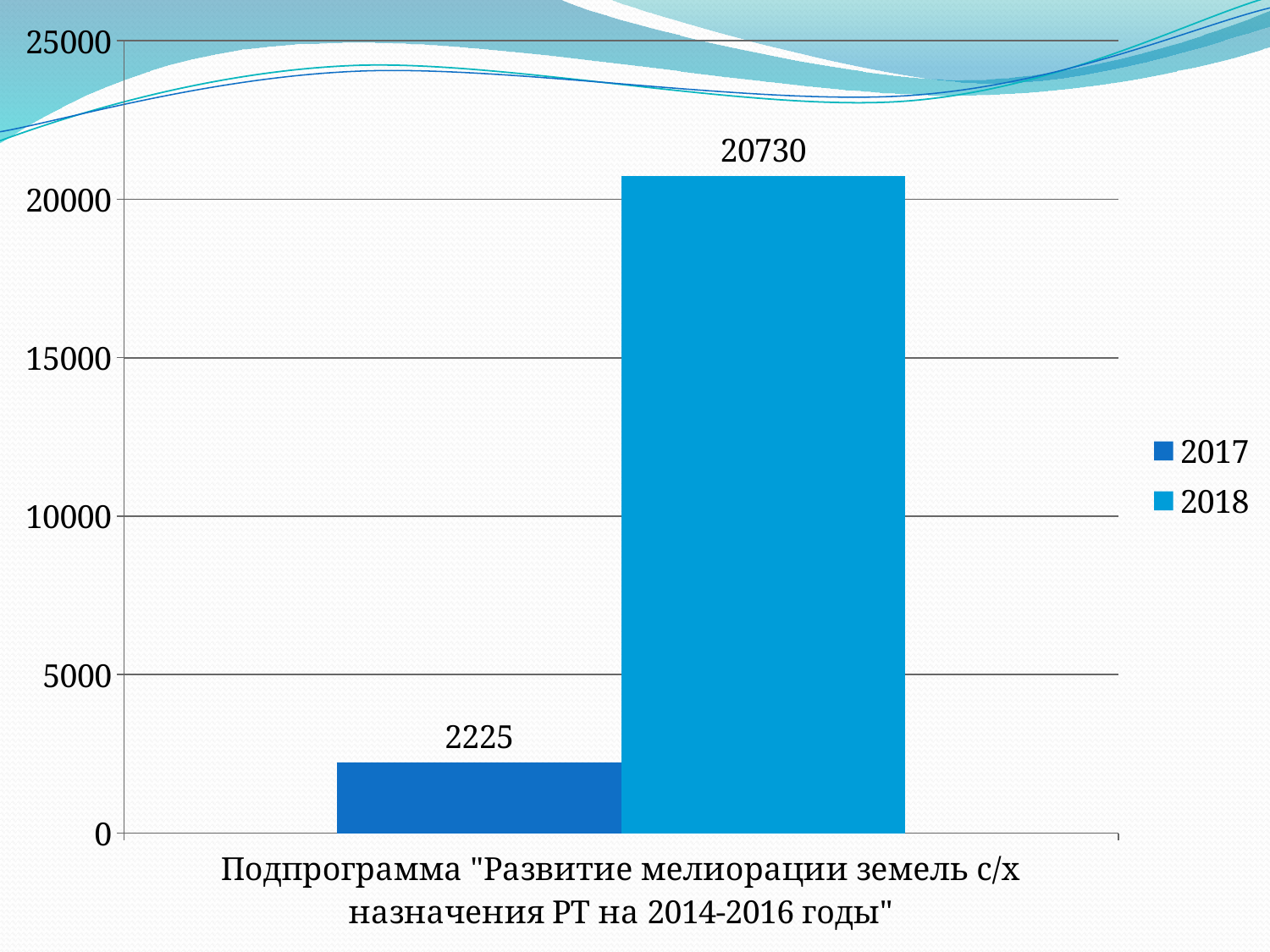
What is the value for 2018? 20730 Is the value for 2017 greater or less than 5000? less What kind of chart is shown on the slide? bar chart What is the difference between the 2018 value and the 2017 value? 18505 Which series has the higher value, 2017 or 2018? 2018 What is the value for 2017? 2225 Which series is shown in the lighter blue colour? 2018 What is the highest value shown on the vertical axis? 25000 Is the value for 2018 greater or less than 20000? greater How many categories are shown on the x axis? 1 Which series has the lower value, 2017 or 2018? 2017 How many series does the legend list? 2